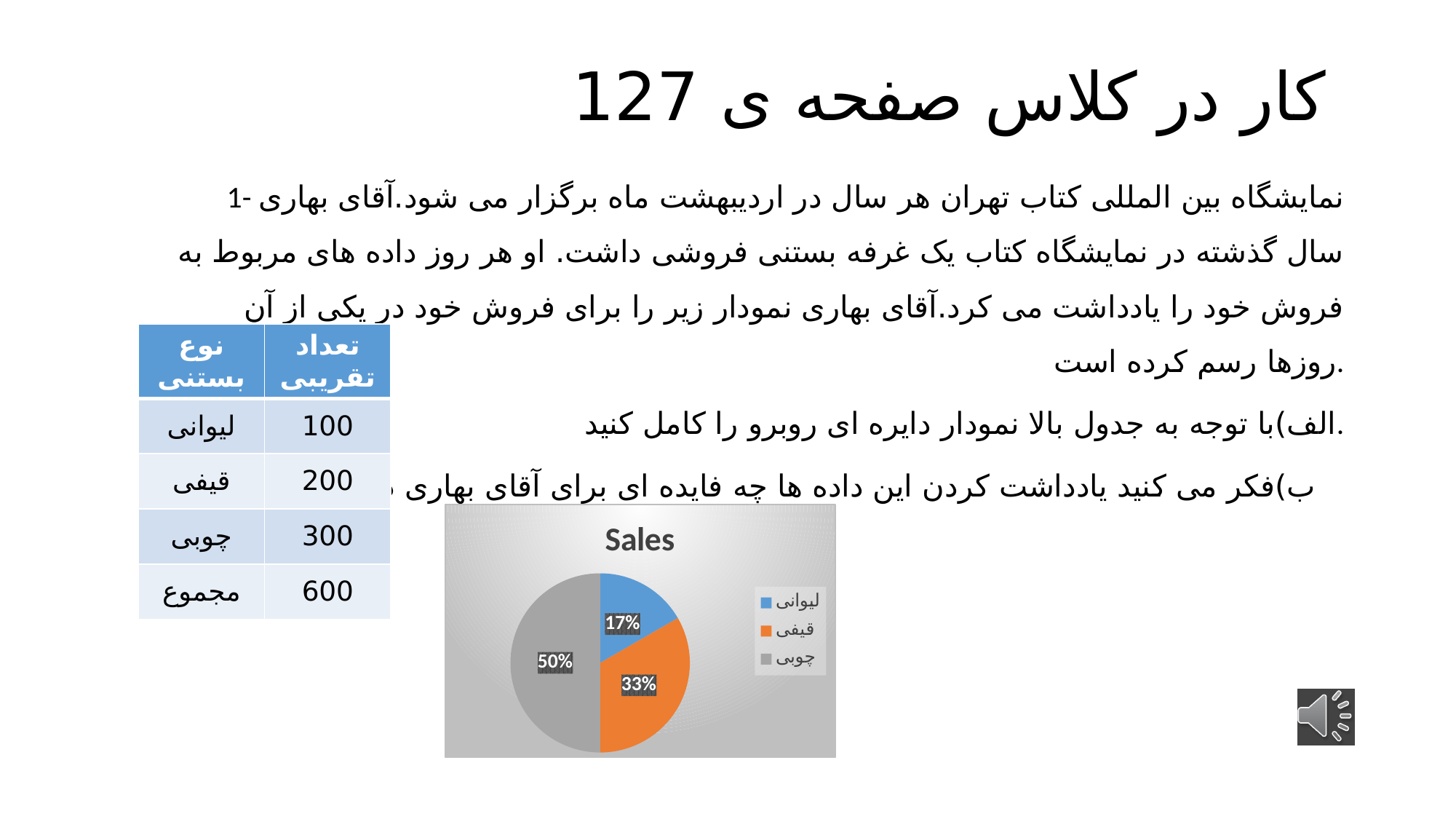
What percentage of the pie is the قیفی slice? 33% How many entries does the chart legend list? 3 Which slice of the pie chart is the smallest? لیوانی What percentage of the pie is the چوبی slice? 50% Which slice of the pie chart is the largest? چوبی What colour is the چوبی slice in the pie chart? grey Which slice is larger, قیفی or لیوانی? قیفی What is the difference in percentage points between the چوبی slice and the لیوانی slice? 33% What is the title of the chart? Sales What kind of chart is shown on the slide? pie chart How many slices does the pie chart have? 3 What percentage of the pie is the لیوانی slice? 17%